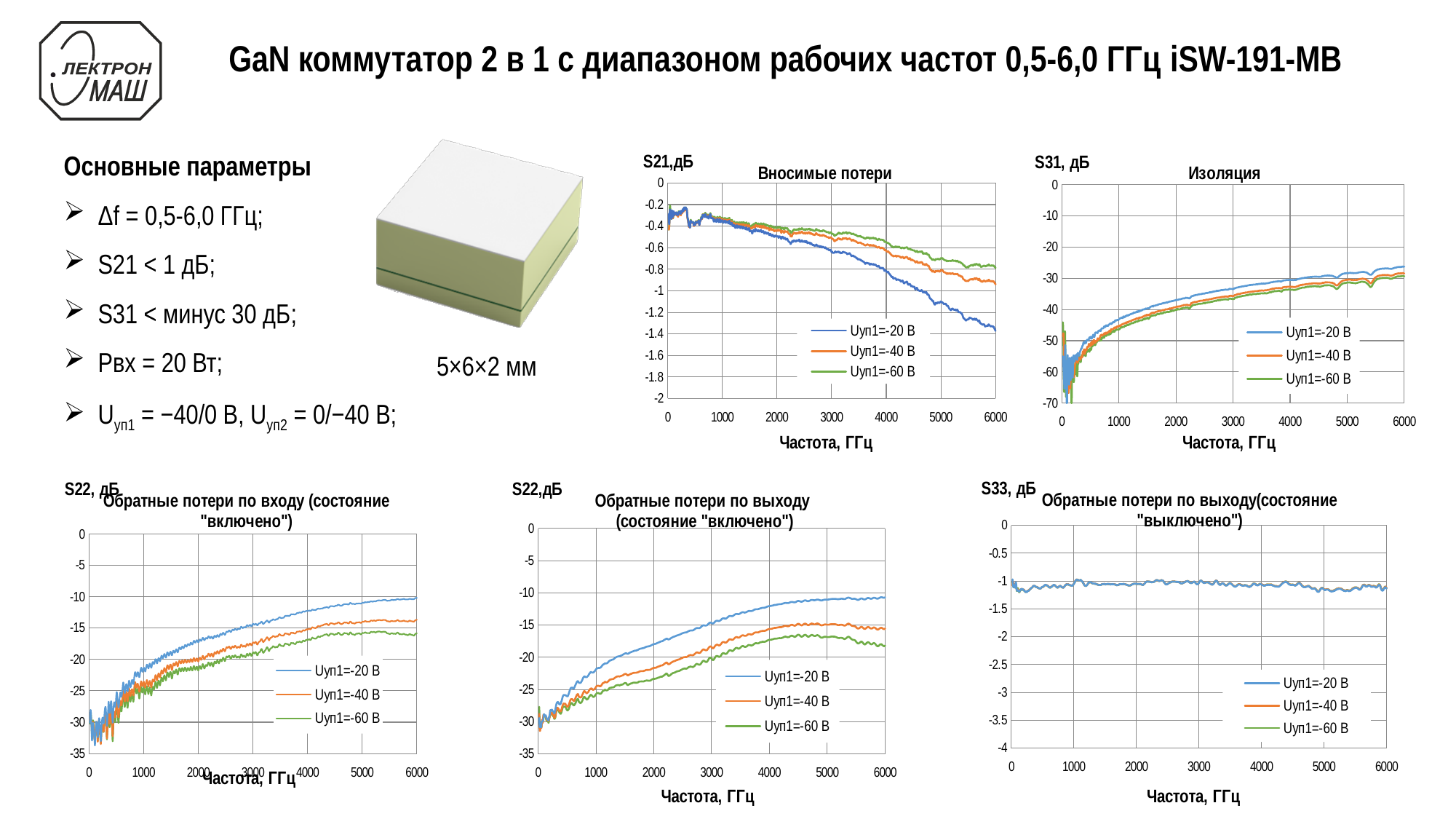
In the "Вносимые потери" chart, do the values rise or fall as frequency increases? fall In the "Обратные потери по выходу (состояние "включено")" chart, is the value of the Uуп1=-60 В series at 6000 greater or less than -15? less How many series does the legend of the "Изоляция" chart list? 3 In the "Обратные потери по выходу(состояние "выключено")" chart, is the plotted value at 3000 greater or less than -1.5? greater In the "Изоляция" chart, do the values rise or fall as frequency increases? rise In the "Вносимые потери" chart, which series has the highest value at 6000? Uуп1=-60 В What kind of chart is the "Вносимые потери" chart? line chart In the "Изоляция" chart, is the value of the Uуп1=-20 В series at 6000 greater or less than -30? greater How many charts are shown on the slide? 5 What is the x-axis label of the "Изоляция" chart? Частота, ГГц